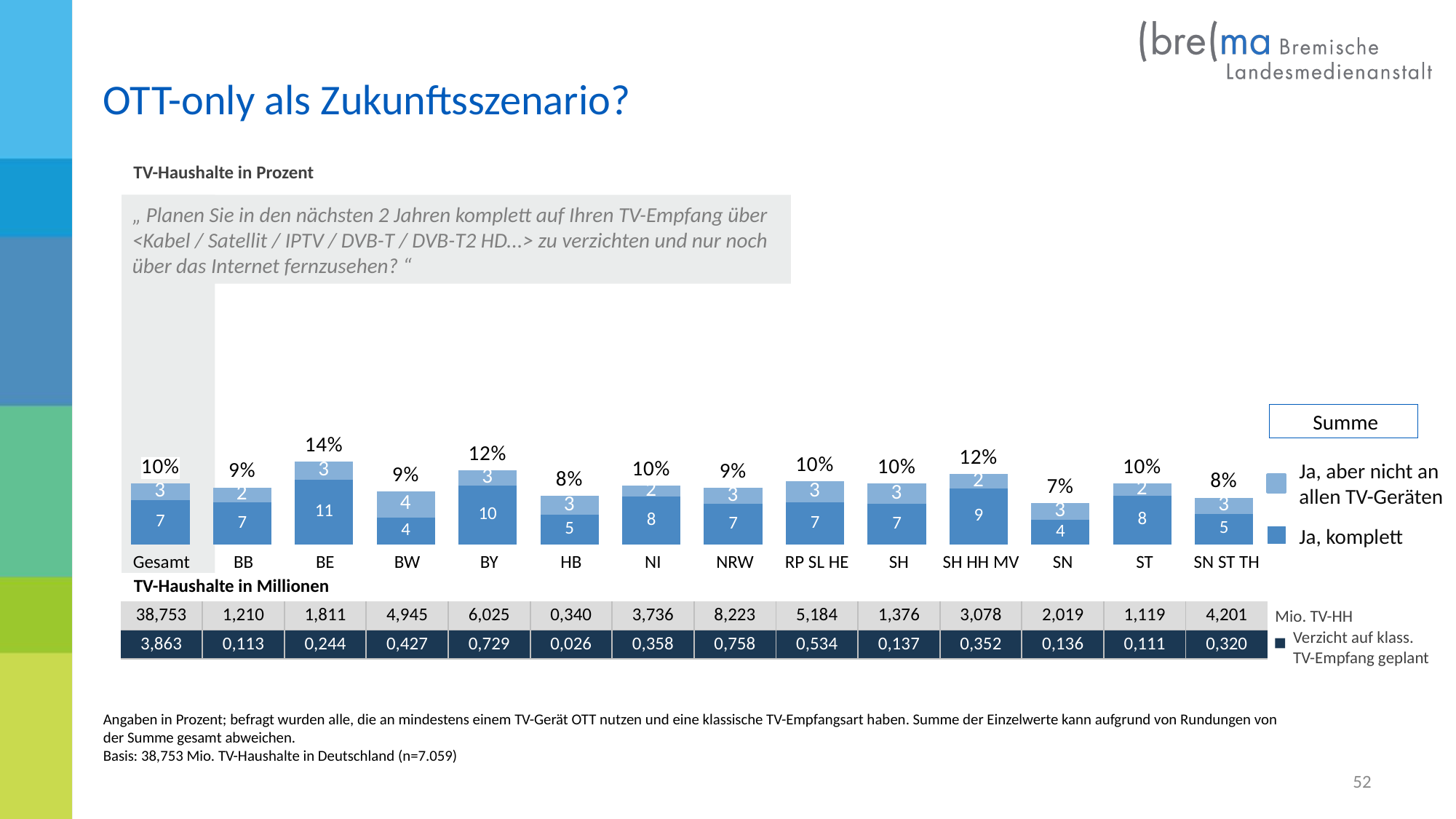
What is the Summe value for Gesamt? 10% Which category has the highest Summe value? BE What is the 'Ja, aber nicht an allen TV-Geräten' value for BW? 4 What is the difference between the 'Ja, komplett' values for BE and SN? 7 What is the 'Ja, komplett' value for BE? 11 What kind of chart is shown on the slide? stacked bar chart How many categories (bars) are shown in the chart? 14 Which category has the lowest Summe value? SN How many series does the legend list? 2 Which is larger, the 'Ja, komplett' value for BY or for HB? BY What is the Summe (total) shown above the bar for BY? 12% Which legend entry is shown in the darker blue colour? Ja, komplett